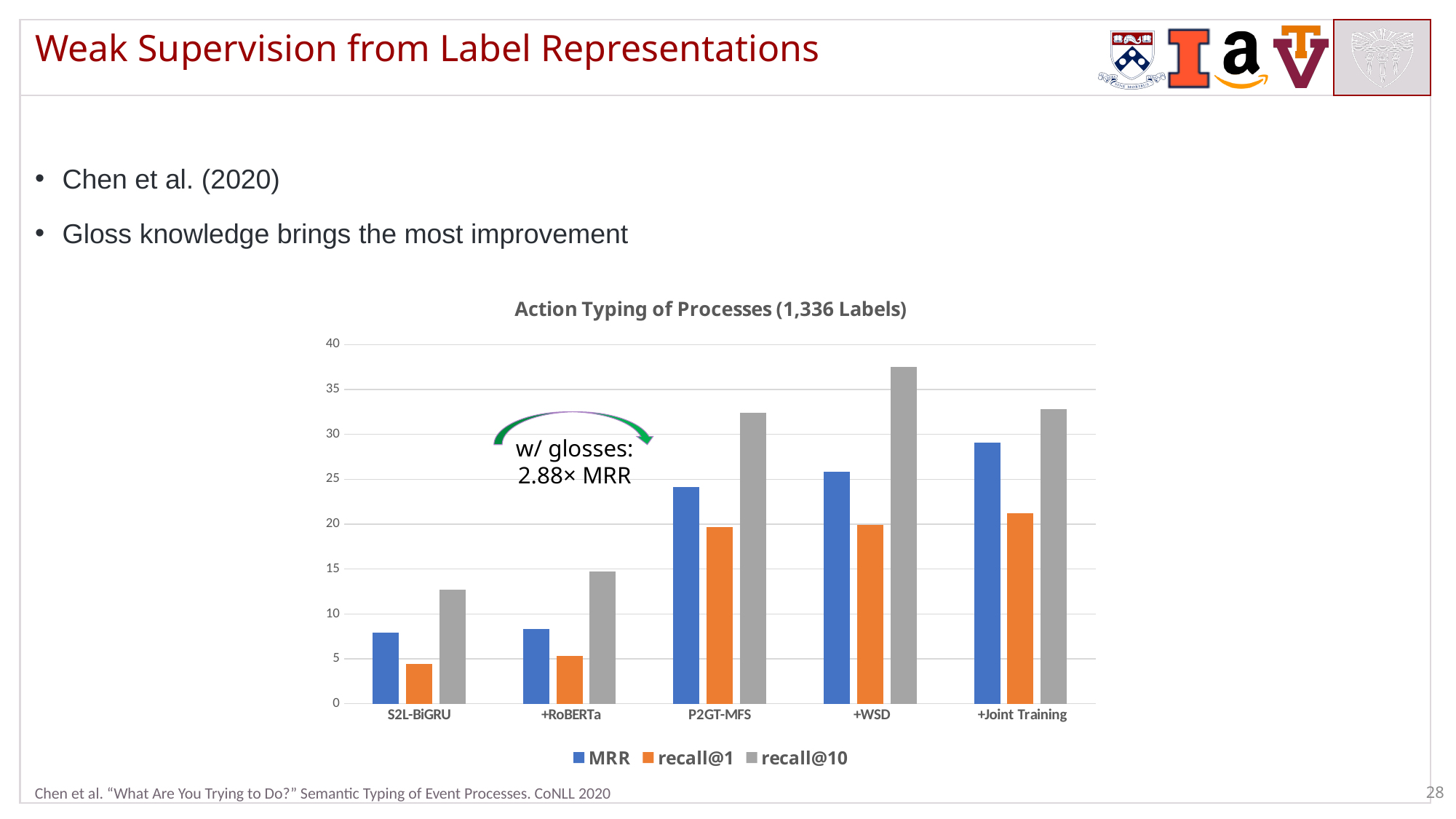
Does the MRR series rise or fall from S2L-BiGRU to +Joint Training along the x axis? rise Which category has the highest MRR value? +Joint Training What is the title of the chart? Action Typing of Processes (1,336 Labels) Is the recall@10 value for +WSD greater or less than 35? greater How many series does the legend list? 3 Which is larger, the MRR value for +WSD or the MRR value for +Joint Training? +Joint Training What kind of chart is shown on the slide? bar chart Which category has the lowest recall@10 value? S2L-BiGRU How many categories are shown on the x axis? 5 Which category has the highest recall@10 value? +WSD Is the recall@1 value for S2L-BiGRU greater or less than 5? less Is the MRR value for +Joint Training greater or less than 30? less